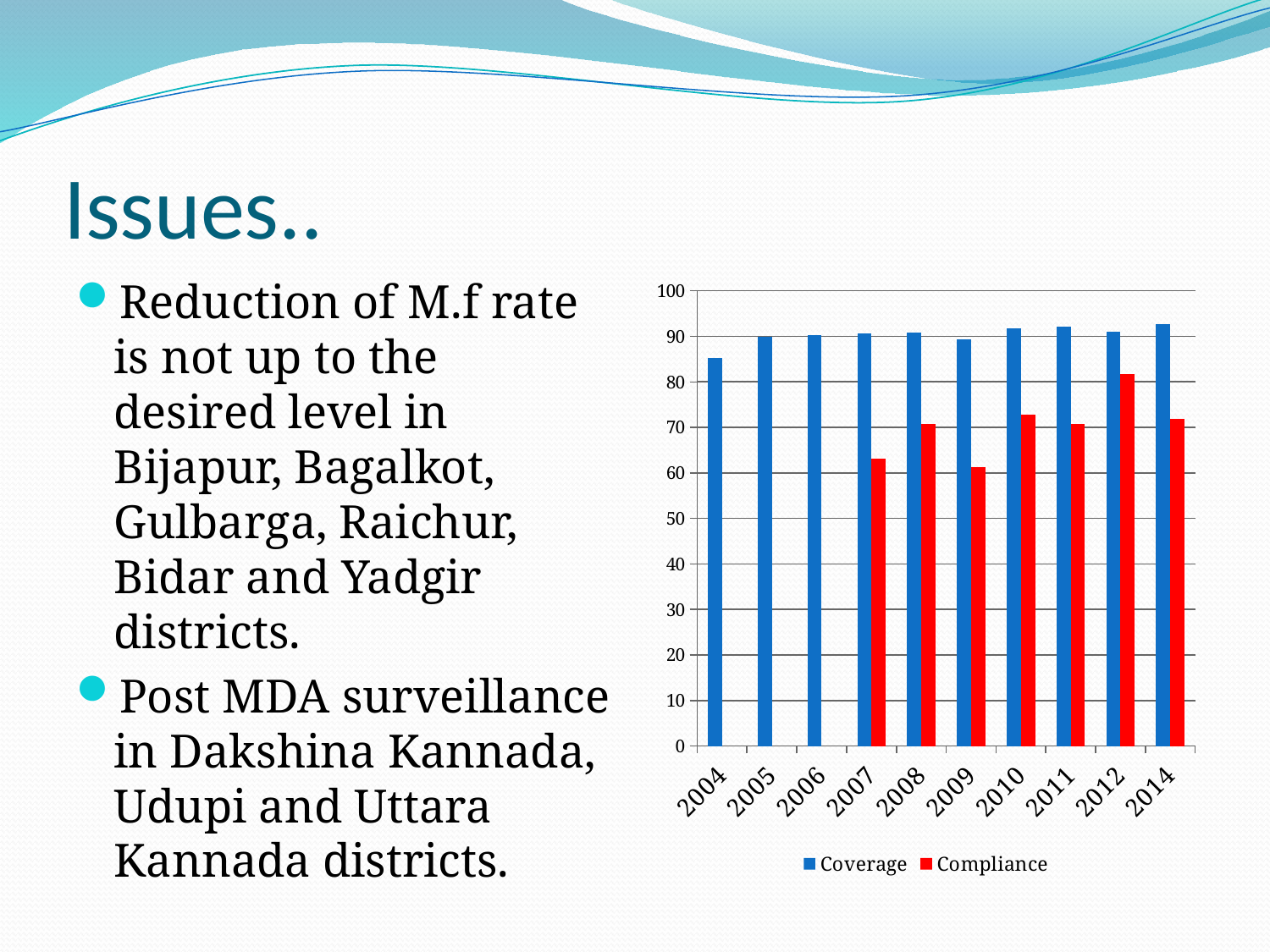
Which year has the highest Compliance value? 2012 Is the Coverage value for 2014 greater or less than 90? greater Is the Compliance value for 2012 greater or less than 80? greater Which year has the lowest Coverage value? 2004 Is the Coverage value for 2004 greater or less than 90? less What are the two series named in the legend? Coverage and Compliance In 2010, which is larger, Coverage or Compliance? Coverage How many years are shown on the x axis of the chart? 10 Which is larger, the Compliance value for 2012 or for 2011? 2012 What kind of chart is shown on the slide? bar chart How many series does the legend list? 2